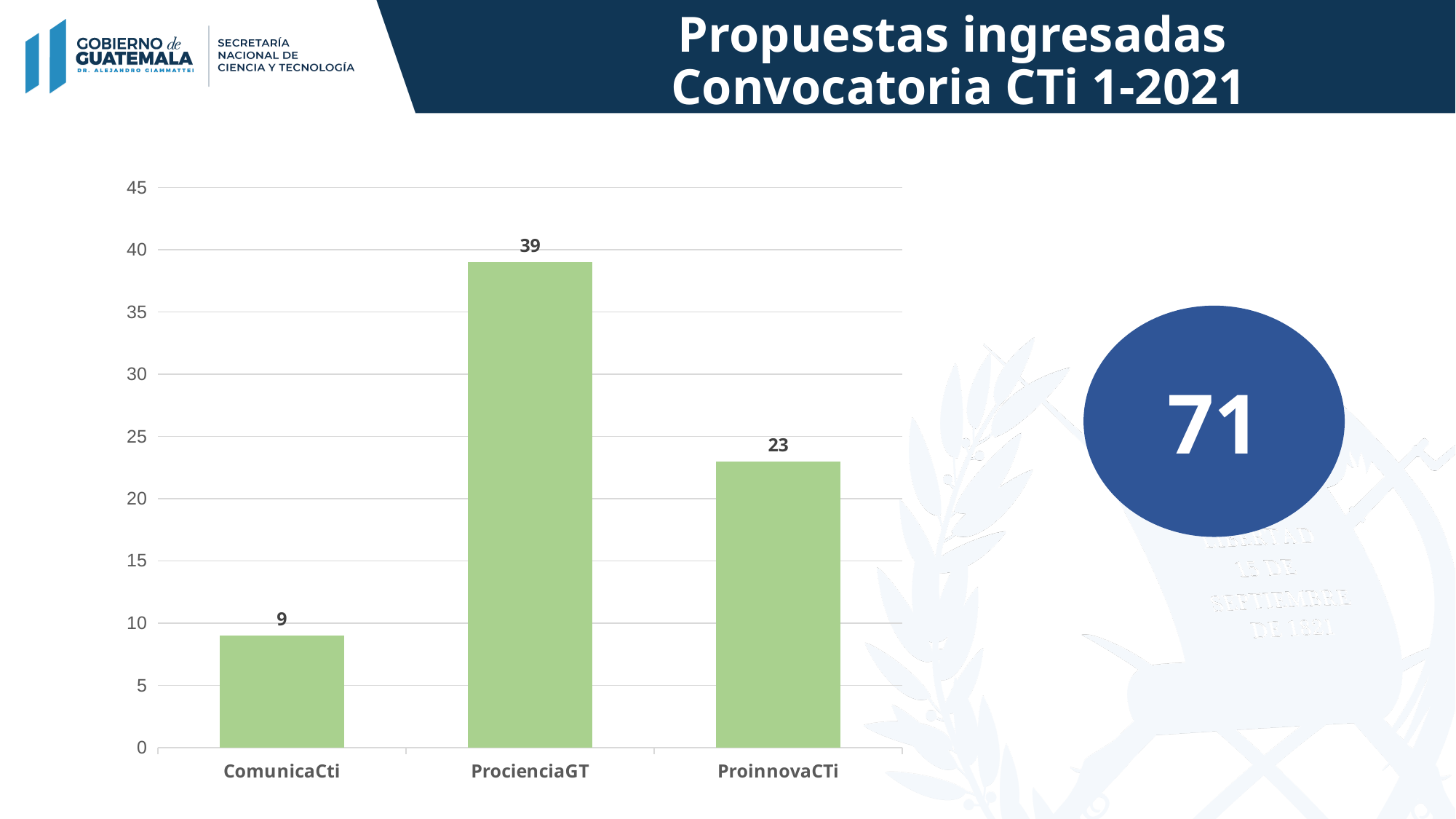
What is the value for ProcienciaGT? 39 Which is larger, the value for ComunicaCti or the value for ProinnovaCTi? ProinnovaCTi What is the value for ProinnovaCTi? 23 What is the difference between the values for ProinnovaCTi and ComunicaCti? 14 Which category has the lowest value? ComunicaCti What kind of chart is shown on the slide? bar chart How many categories are shown on the x axis? 3 What is the value for ComunicaCti? 9 Which category has the highest value? ProcienciaGT What is the title of the slide containing the chart? Propuestas ingresadas Convocatoria CTi 1-2021 What is the difference between the values for ProcienciaGT and ProinnovaCTi? 16 Is the value for ProcienciaGT greater or less than 35? greater